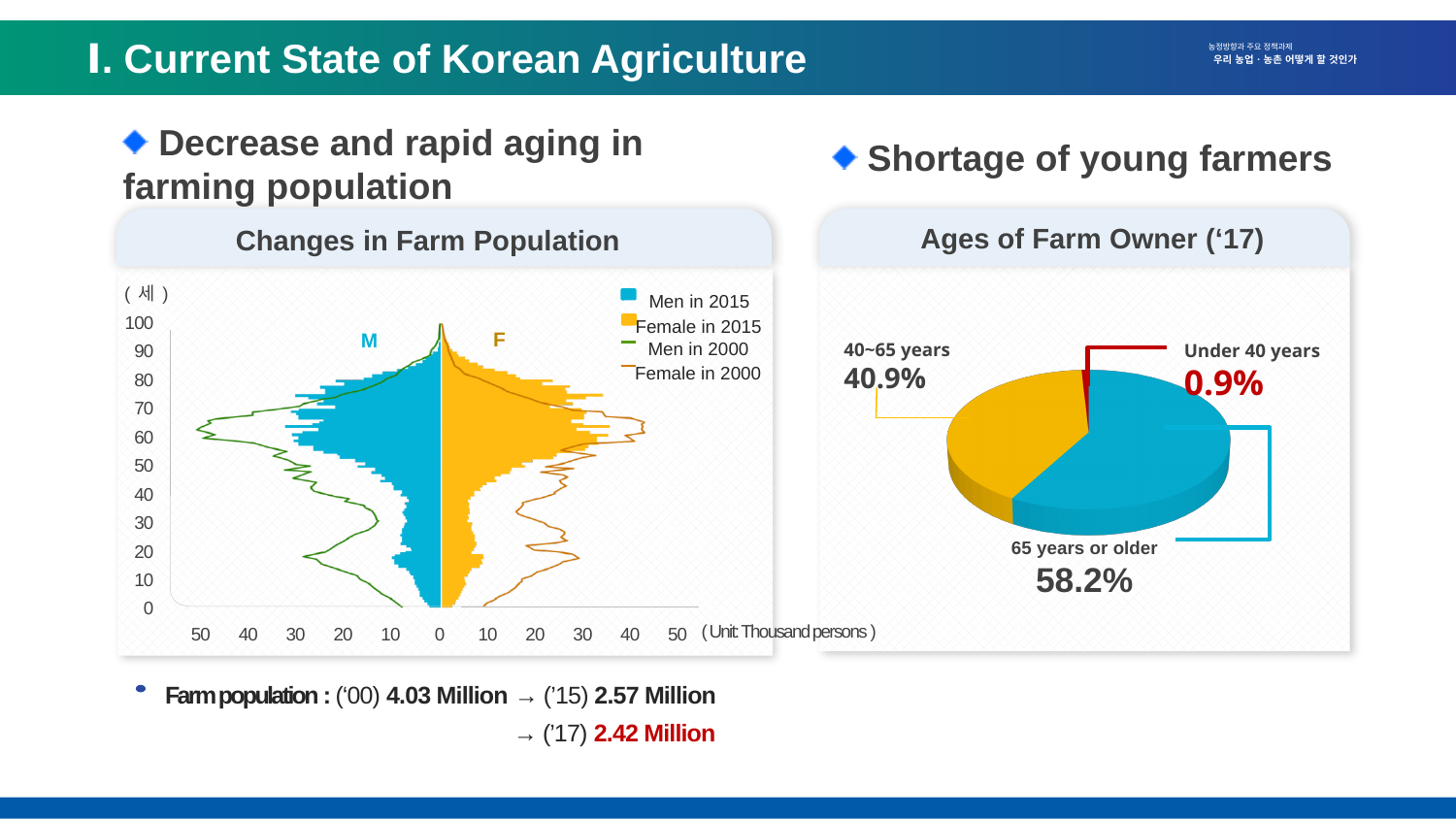
In the 'Ages of Farm Owner ('17)' chart, what share of farm owners are under 40 years? 0.9% How many slices does the 'Ages of Farm Owner ('17)' chart have? 3 In the 'Ages of Farm Owner ('17)' chart, what is the difference in percentage points between the 65 years or older group and the 40~65 years group? 17.3 In the 'Ages of Farm Owner ('17)' chart, what share of farm owners are 40~65 years? 40.9% What kind of chart is 'Changes in Farm Population'? Bar chart In the 'Ages of Farm Owner ('17)' chart, which age group has the smallest share? Under 40 years In the 'Ages of Farm Owner ('17)' chart, what share of farm owners are 65 years or older? 58.2% In the 'Ages of Farm Owner ('17)' chart, which age group has the largest share? 65 years or older How many series does the legend of the 'Changes in Farm Population' chart list? 4 In the 'Ages of Farm Owner ('17)' chart, which is larger: the share of 40~65 years or the share of under 40 years? 40~65 years What kind of chart is 'Ages of Farm Owner ('17)'? Pie chart What unit is stated for the 'Changes in Farm Population' chart? Thousand persons